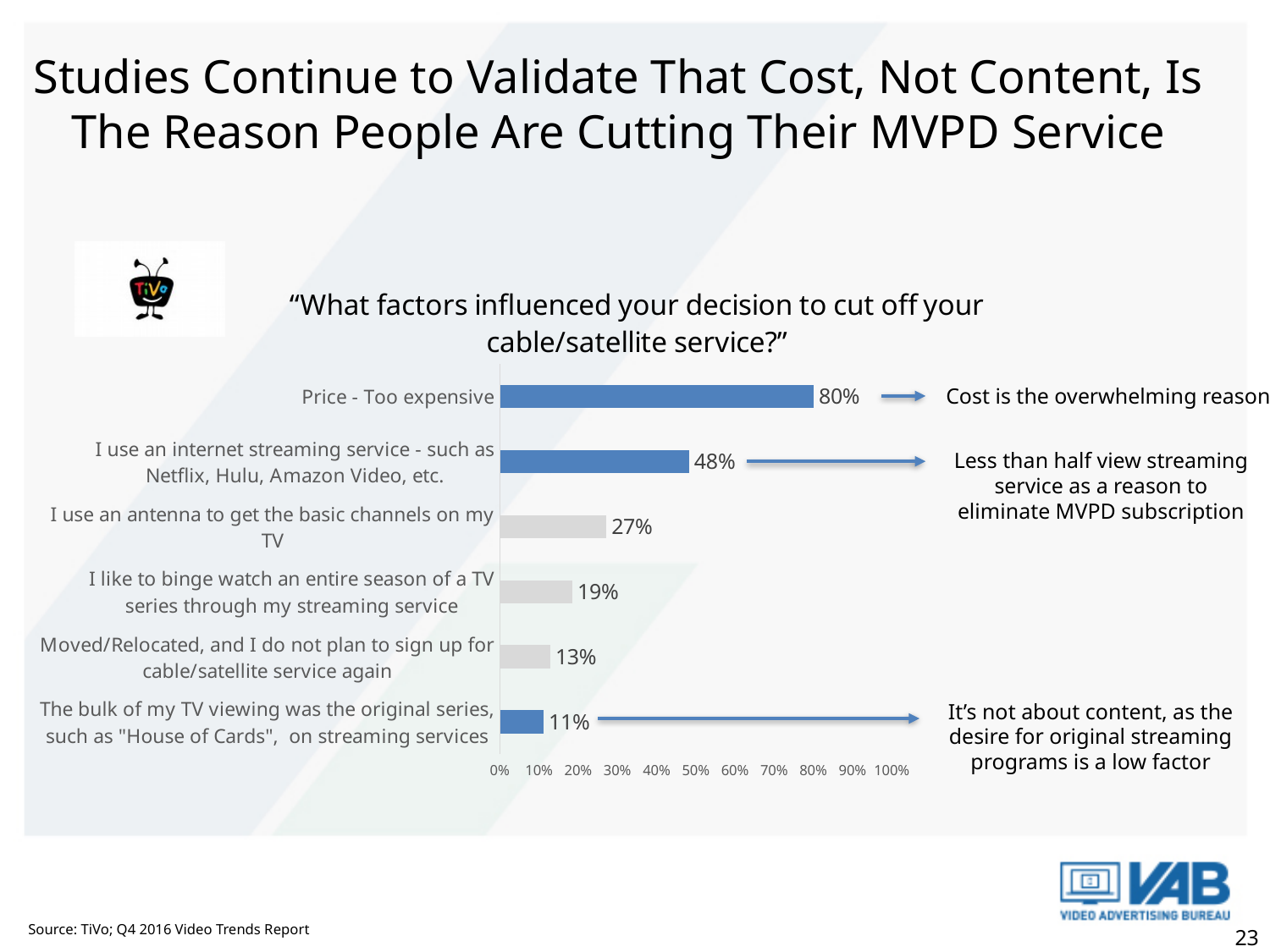
What is the difference in percentage points between the binge-watching factor (19%) and the moved/relocated factor (13%)? 6 What is the value for "I use an antenna to get the basic channels on my TV"? 27% What percentage cited "Moved/Relocated, and I do not plan to sign up for cable/satellite service again"? 13% Which factor has the lowest percentage in the chart? The bulk of my TV viewing was the original series, such as "House of Cards", on streaming services Which is larger: the value for using an antenna or the value for binge watching through a streaming service? I use an antenna to get the basic channels on my TV How many factors (categories) are shown in the bar chart? 6 What is the difference in percentage points between "Price - Too expensive" and "I use an internet streaming service"? 32 What percentage of respondents cited "Price - Too expensive" as a factor in cutting their cable/satellite service? 80% Which factor has the highest percentage in the chart? Price - Too expensive Is the value for "I use an internet streaming service" greater or less than 50%? less What type of chart is used on this slide? Bar chart What is the source cited for the chart data? TiVo; Q4 2016 Video Trends Report